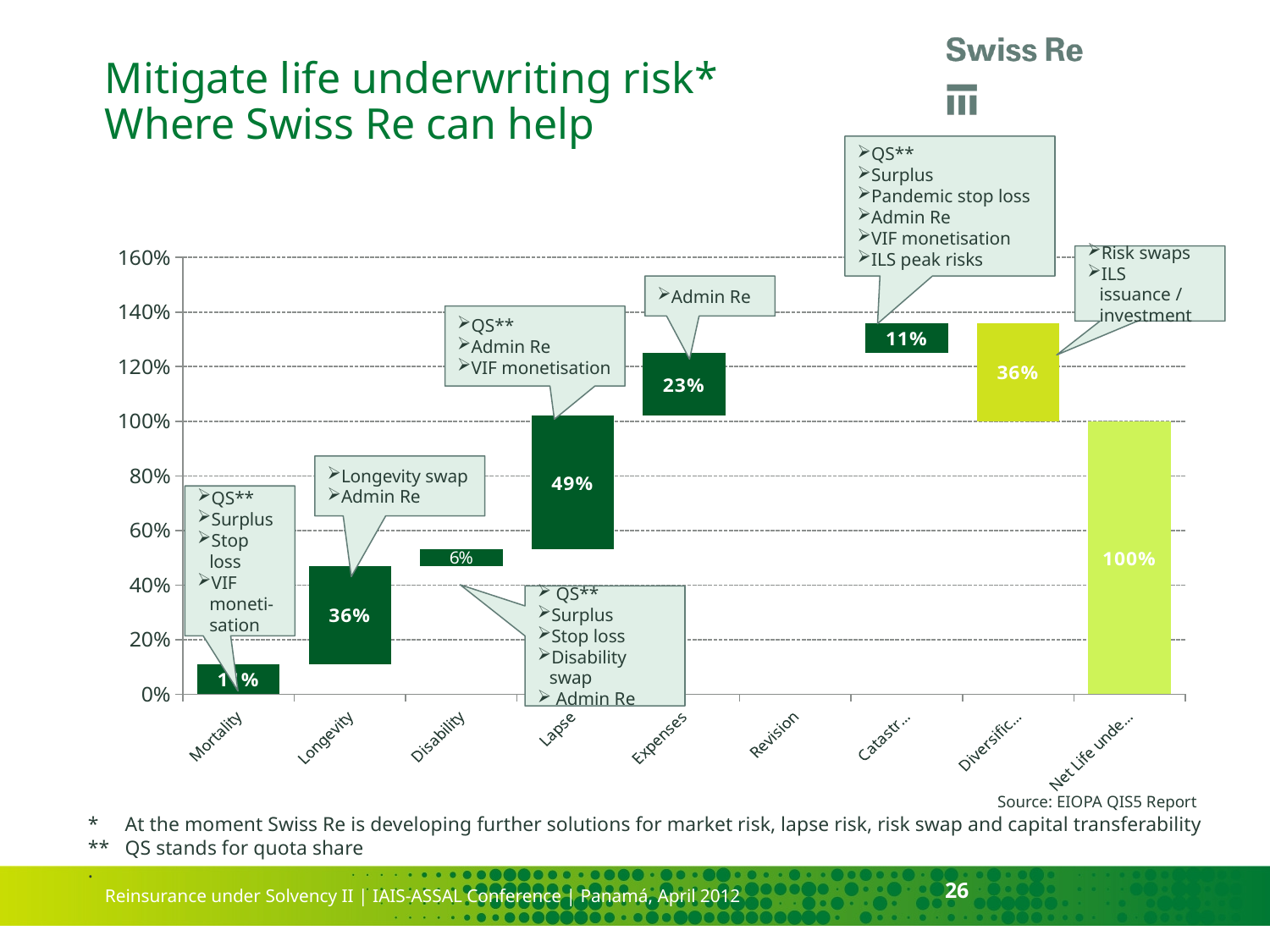
What is the difference between the labelled values for Lapse and Expenses? 26% What source is cited for the chart? EIOPA QIS5 Report Which has the larger labelled value, Longevity or Expenses? Longevity Excluding the final Net Life unde... bar, which category has the highest labelled value? Lapse What kind of chart is shown on the slide? Bar chart What is the labelled value for Lapse? 49% How many categories are listed along the x axis? 9 What is the labelled value for Longevity? 36% What is the labelled value for Disability? 6% What is the labelled value for Expenses? 23% What is the labelled value for the Catastr... category? 11% What is the labelled value for the final Net Life unde... bar? 100%